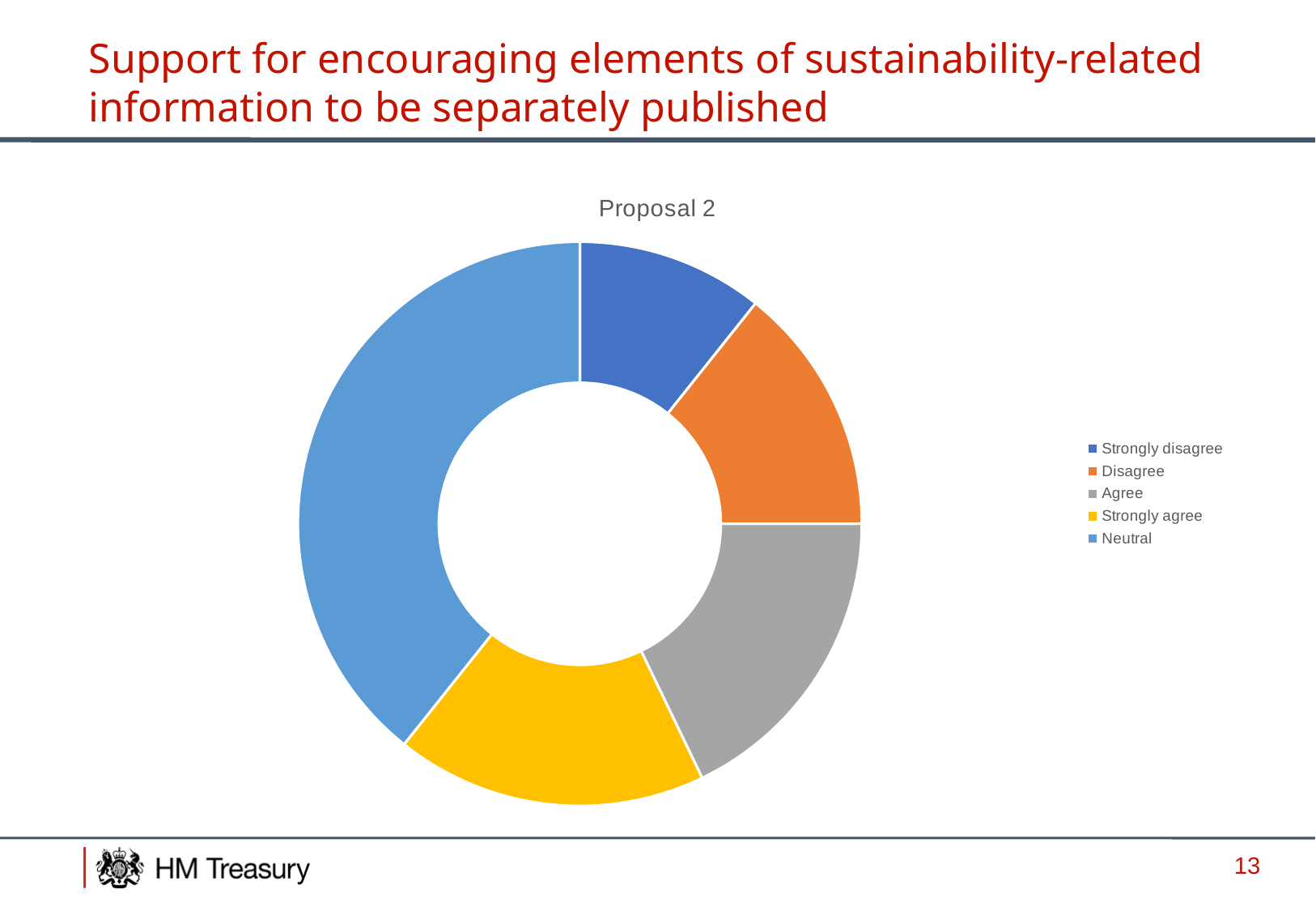
Which colour represents the Strongly agree category in the chart? Yellow How many categories does the chart show? 5 Which slice is larger, Strongly disagree or Neutral? Neutral Which category has the smallest slice of the chart? Strongly disagree Which slice is larger, Agree or Strongly disagree? Agree Which slice is larger, Neutral or Agree? Neutral What kind of chart is shown on the slide? Doughnut (pie) chart Which category has the largest slice of the chart? Neutral How many entries does the legend list? 5 What is the title of the chart? Proposal 2